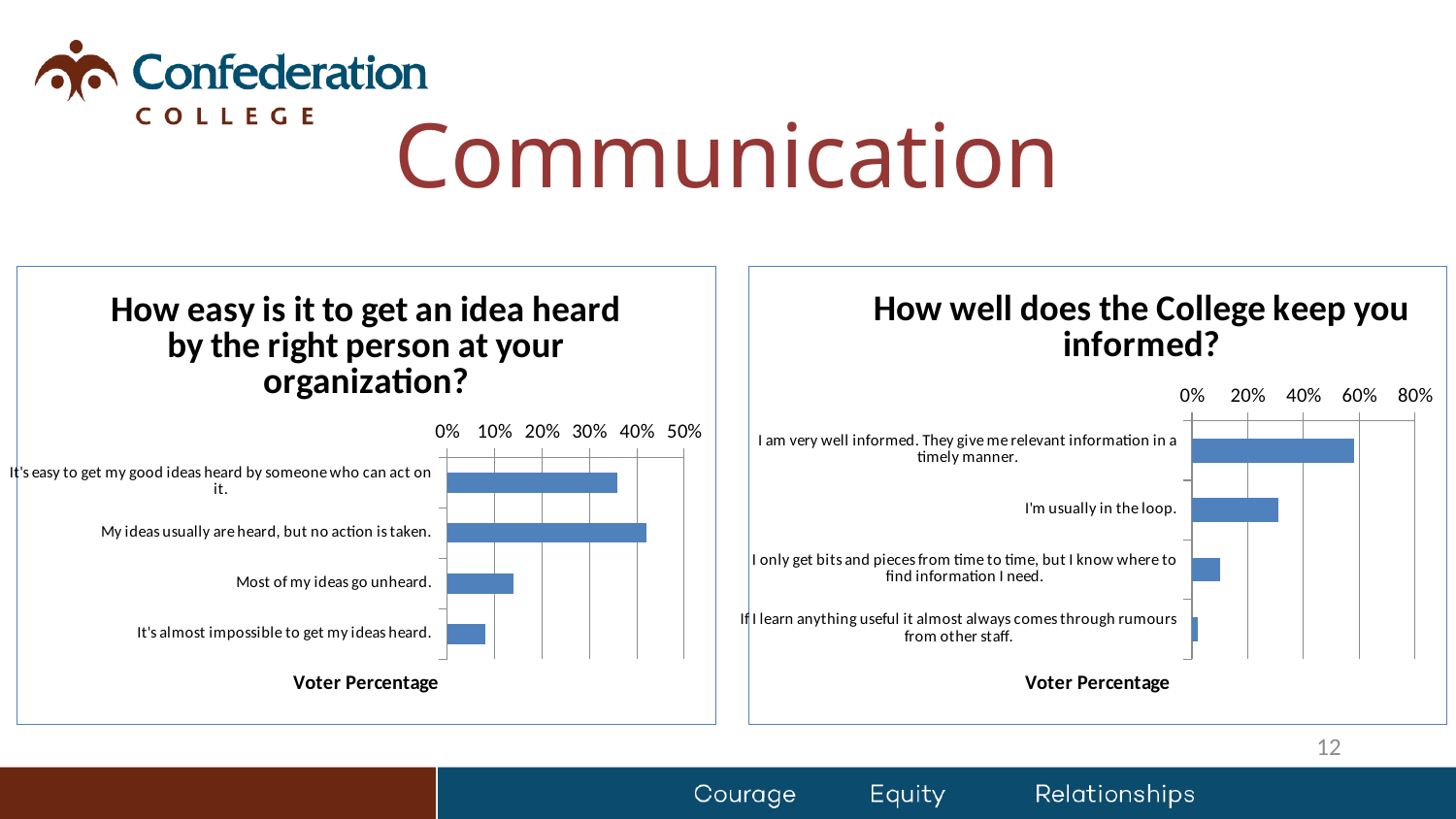
In the chart titled "How easy is it to get an idea heard by the right person at your organization?", is the value for "It's easy to get my good ideas heard by someone who can act on it." greater or less than 30%? greater In the chart titled "How well does the College keep you informed?", which response has the highest voter percentage? I am very well informed. They give me relevant information in a timely manner. In the chart titled "How well does the College keep you informed?", what is the label on the horizontal axis? Voter Percentage In the chart titled "How well does the College keep you informed?", which response has the lowest voter percentage? If I learn anything useful it almost always comes through rumours from other staff. In the chart titled "How easy is it to get an idea heard by the right person at your organization?", is the value for "Most of my ideas go unheard." greater or less than 20%? less In the chart titled "How well does the College keep you informed?", which is larger: the value for "I'm usually in the loop." or the value for "I only get bits and pieces from time to time, but I know where to find information I need."? I'm usually in the loop. In the chart titled "How well does the College keep you informed?", is the value for "I'm usually in the loop." greater or less than 40%? less In the chart titled "How easy is it to get an idea heard by the right person at your organization?", which response has the highest voter percentage? My ideas usually are heard, but no action is taken. In the chart titled "How easy is it to get an idea heard by the right person at your organization?", which response has the lowest voter percentage? It's almost impossible to get my ideas heard. In the chart titled "How well does the College keep you informed?", what is the highest tick value shown on the horizontal axis? 80% In the chart titled "How easy is it to get an idea heard by the right person at your organization?", what kind of chart is shown? bar chart In the chart titled "How easy is it to get an idea heard by the right person at your organization?", how many response categories are plotted? 4